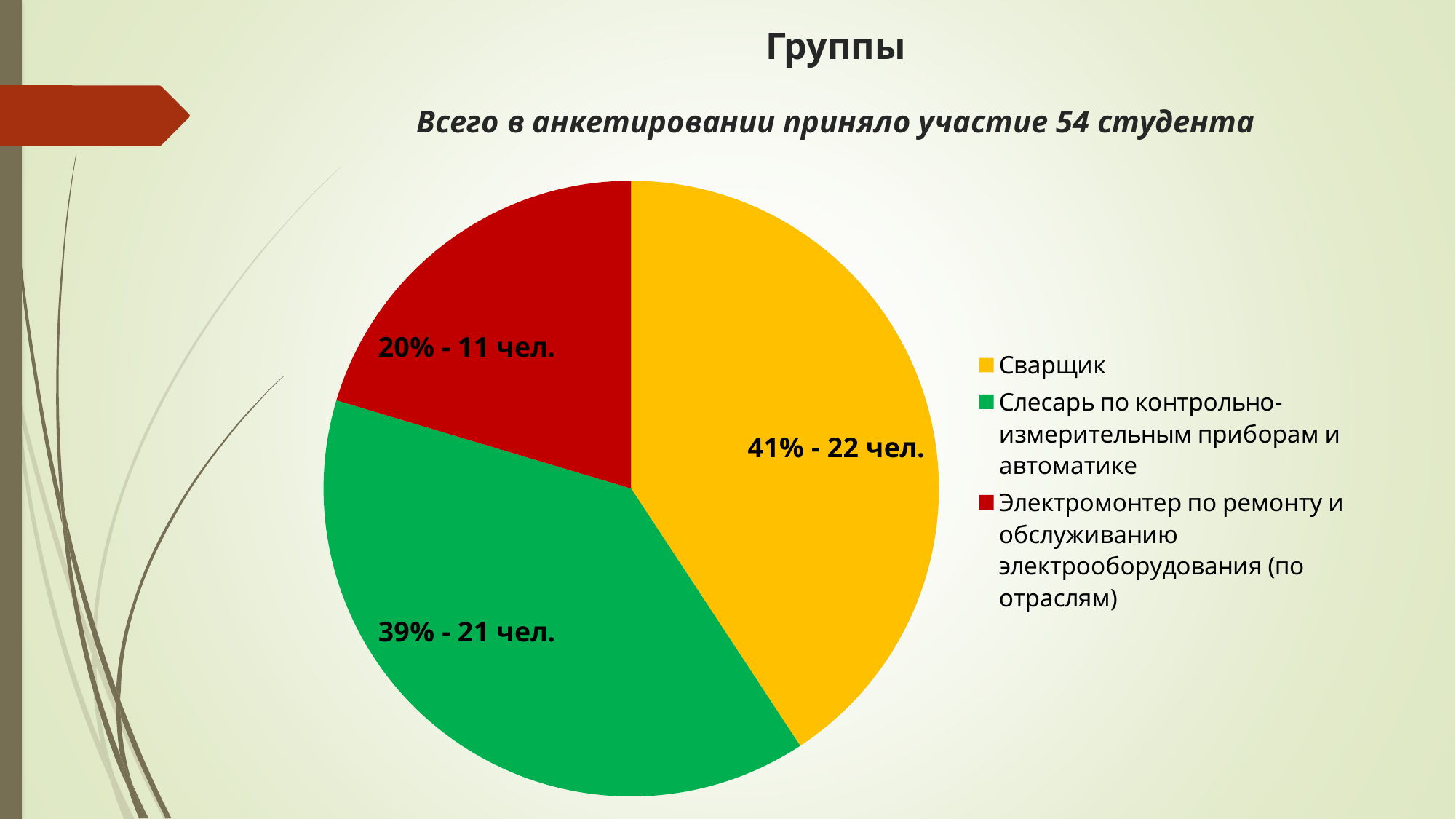
What is the difference in number of people between the Сварщик group and the Электромонтер group? 11 How many slices does the pie chart have? 3 What share of the pie does the Сварщик slice represent? 41% How many students took part in the survey in total, according to the subtitle? 54 Which group has the largest slice of the pie? Сварщик What share of the pie does the Слесарь по контрольно-измерительным приборам и автоматике slice represent? 39% What is the title of the chart? Группы How many people are in the Электромонтер по ремонту и обслуживанию электрооборудования (по отраслям) group? 11 чел. Which group has the smallest slice of the pie? Электромонтер по ремонту и обслуживанию электрооборудования (по отраслям) Which colour represents the Слесарь по контрольно-измерительным приборам и автоматике group? Green What kind of chart is shown on the slide? Pie chart How many people are in the Сварщик group according to the data label? 22 чел.